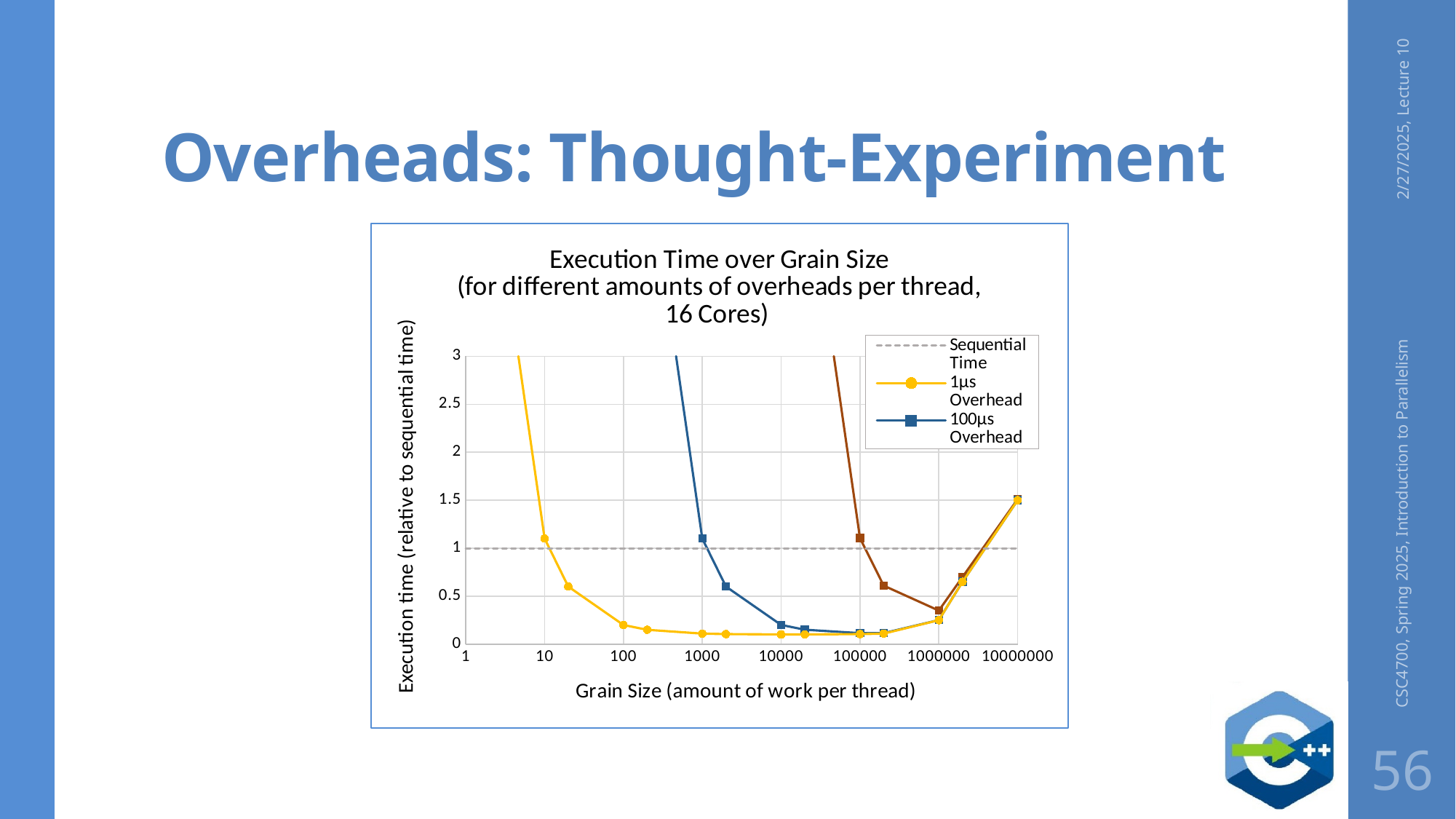
Is the value of the 100µs Overhead series at grain size 10000 greater or less than 0.5? less What is the label of the x axis? Grain Size (amount of work per thread) Does the 1µs Overhead series rise or fall as grain size increases from 10 to 1000? fall How many series does the chart legend list? 3 At what execution time value does the dashed Sequential Time line sit? 1 At grain size 1000, which series has the higher execution time, 1µs Overhead or 100µs Overhead? 100µs Overhead Does the 100µs Overhead series rise or fall as grain size increases from 100000 to 10000000? rise Is the value of the 100µs Overhead series at grain size 1000 greater or less than 0.5? greater Is the value of the 1µs Overhead series at grain size 10000000 greater or less than 1? greater What kind of chart is shown on the slide? line chart What is the title of the chart? Execution Time over Grain Size (for different amounts of overheads per thread, 16 Cores)